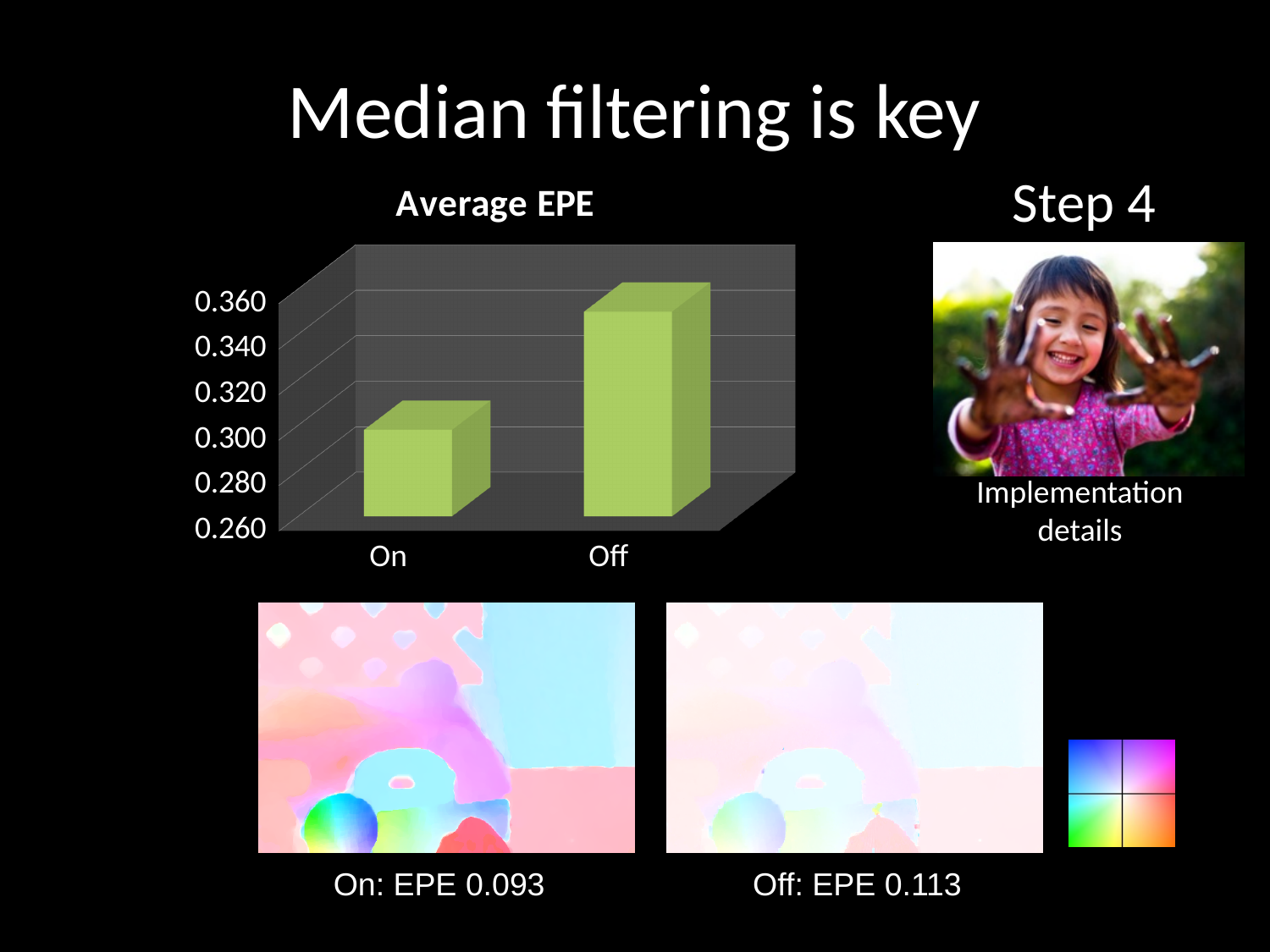
Is the value for On greater or less than 0.320? less What type of chart is shown on the slide? bar chart Is the value for Off greater or less than 0.320? greater Which category has the highest value in the Average EPE chart? Off What is the title of the chart? Average EPE What is the lowest value shown on the vertical axis of the chart? 0.260 Which is larger in the Average EPE chart, the value for On or the value for Off? Off Which category has the lowest value in the Average EPE chart? On Is the value for On greater or less than 0.280? greater How many categories are plotted in the Average EPE chart? 2 Do the values rise or fall from On to Off along the x axis? rise